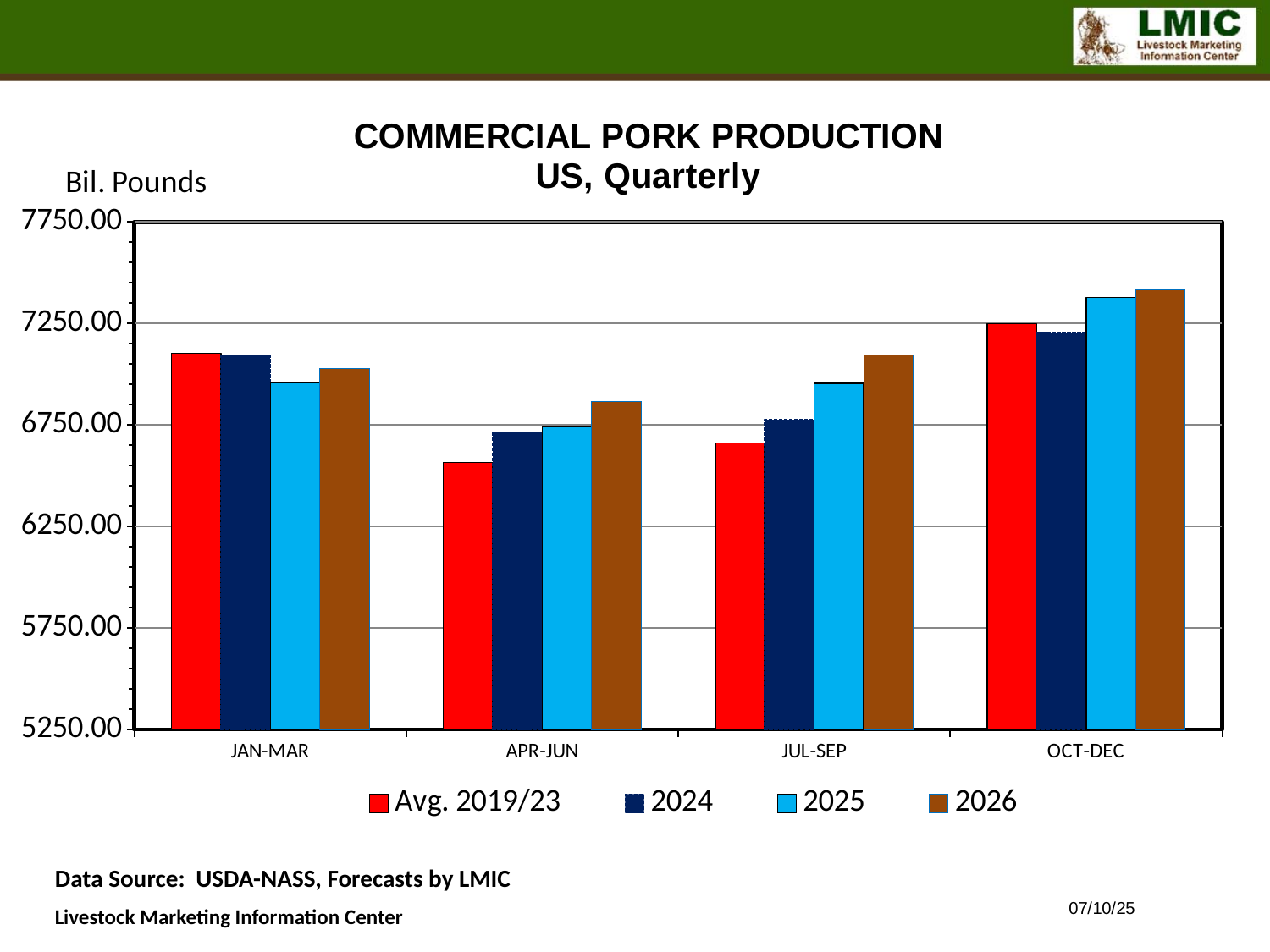
How many quarters (categories) are shown on the x axis? 4 What kind of chart is shown on the slide? Bar chart Is the value for 2026 in APR-JUN greater or less than 6750.00? greater Is the value for Avg. 2019/23 in APR-JUN greater or less than 6750.00? less Is the value for Avg. 2019/23 in JUL-SEP greater or less than 6750.00? less What unit is shown on the y axis label? Bil. Pounds In JUL-SEP, which is larger: the 2025 value or the 2024 value? 2025 In which quarter is the Avg. 2019/23 value lowest? APR-JUN In which quarter is the 2026 value highest? OCT-DEC Which series is shown in red in the legend? Avg. 2019/23 How many series does the legend list? 4